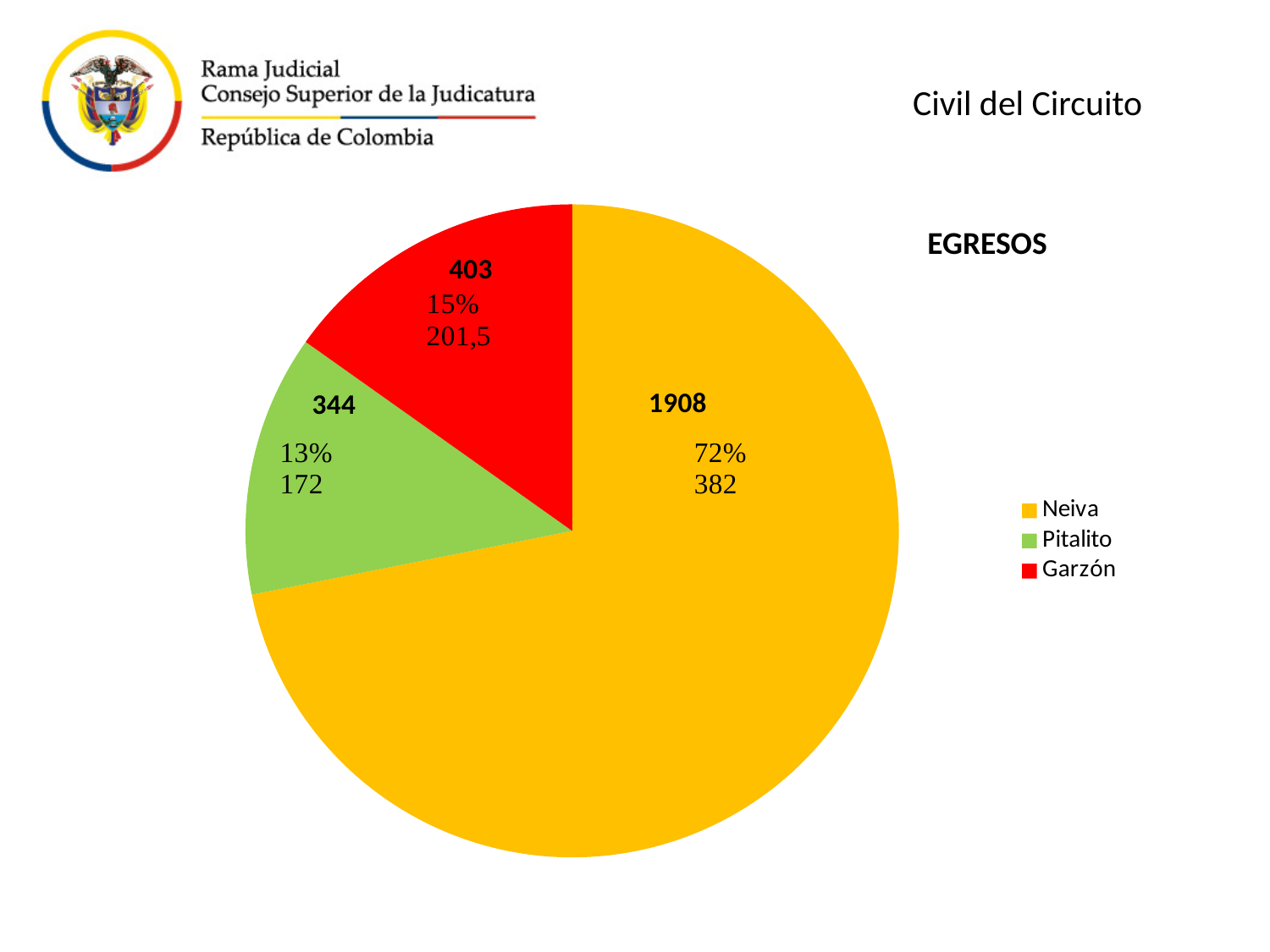
What is the value shown for Pitalito? 344 What is the value shown for Garzón? 403 What is the value shown for Neiva? 1908 How many slices does the pie chart have? 3 What percentage share of the pie does Garzón have? 15% Which category has the largest slice? Neiva What is the difference between the values for Garzón and Pitalito? 59 How many entries does the legend list? 3 Which category has the smallest slice? Pitalito What is the title of the chart? EGRESOS What kind of chart is shown on the slide? pie chart What percentage share of the pie does Neiva have? 72%